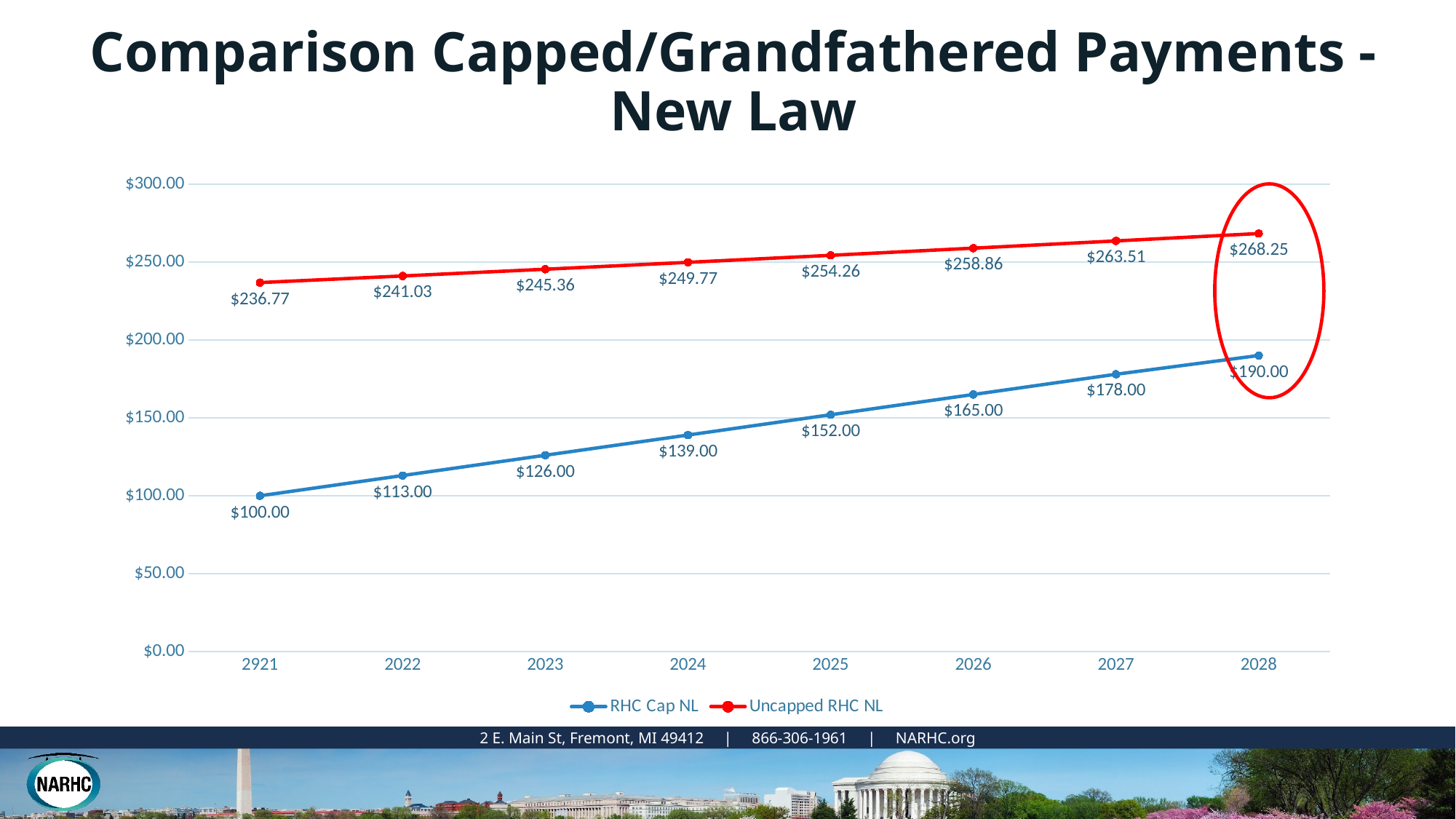
In which year is the Uncapped RHC NL value lowest? 2921 What is the value of Uncapped RHC NL in 2024? $249.77 How many series does the legend list? 2 By how much does RHC Cap NL increase from 2026 to 2027? $13.00 What is the value of Uncapped RHC NL in 2028? $268.25 In 2026, which series has the higher value, RHC Cap NL or Uncapped RHC NL? Uncapped RHC NL What is the difference between Uncapped RHC NL and RHC Cap NL in 2028? $78.25 How many years are plotted along the x axis? 8 What type of chart is shown on the slide? line chart Is the value for RHC Cap NL in 2027 greater or less than $150.00? greater What is the value of RHC Cap NL in 2025? $152.00 In which year does RHC Cap NL reach its highest value? 2028